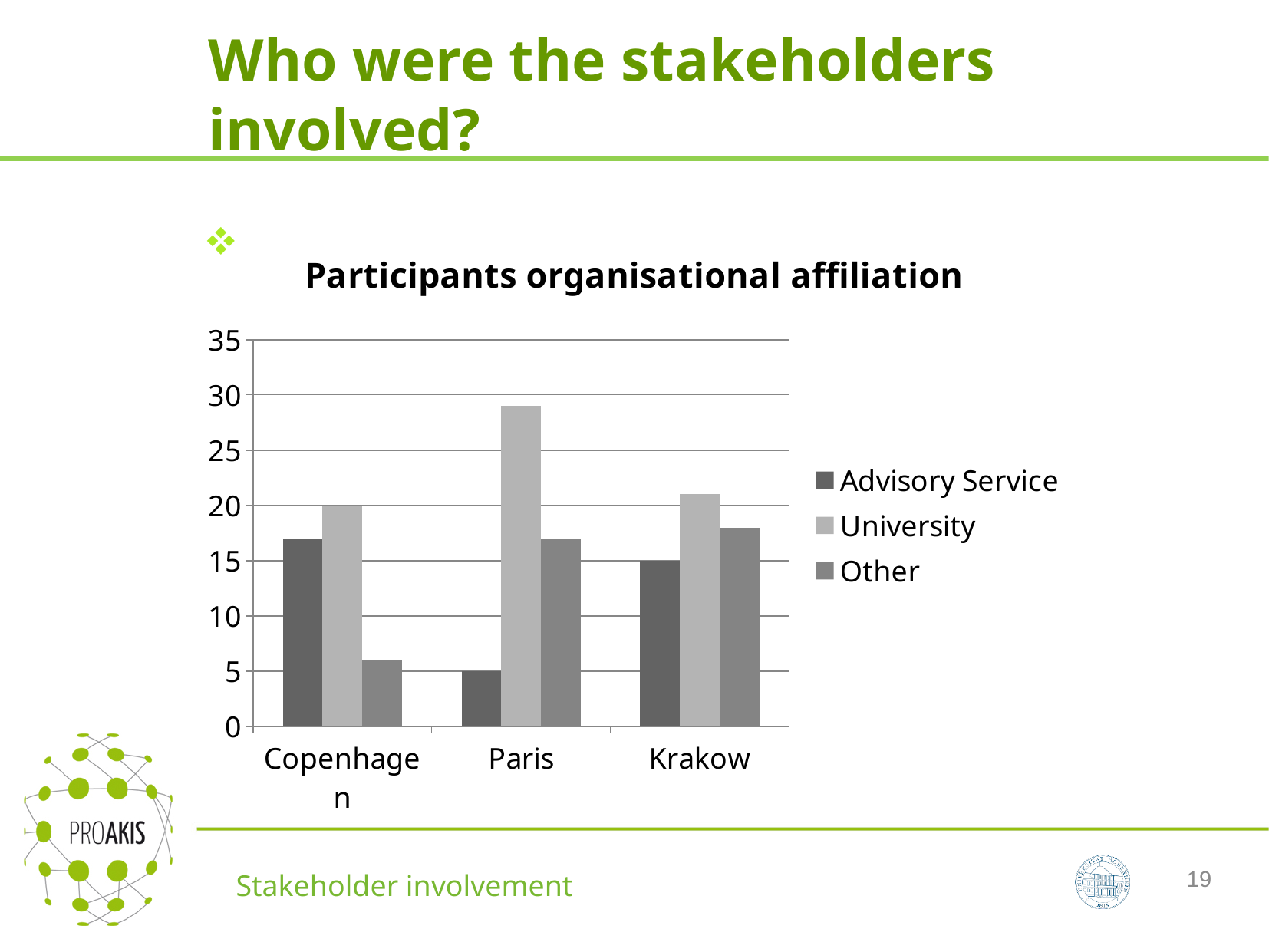
Is the Other value for Copenhagen greater or less than 10? less Which is larger for Paris, the University value or the Other value? University What is the Advisory Service value for Krakow? 15 What type of chart is shown on the slide? bar chart What is the University value for Copenhagen? 20 What is the Advisory Service value for Paris? 5 Which category has the highest University value? Paris Is the University value for Paris greater or less than 25? greater Which category has the lowest Other value? Copenhagen How many categories are shown on the x axis? 3 What is the title of the chart? Participants organisational affiliation How many series does the legend list? 3